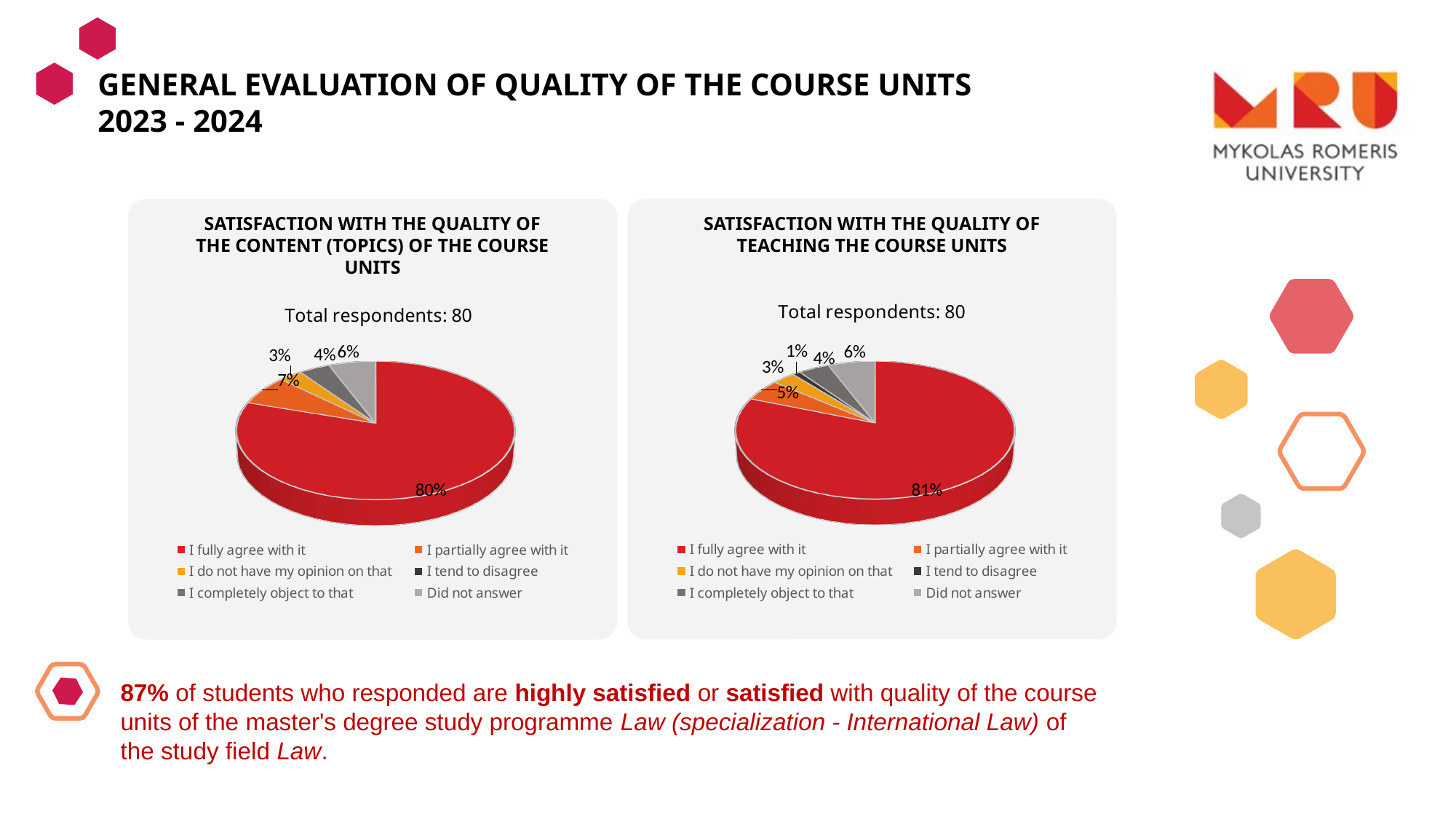
In the 'Satisfaction with the quality of teaching the course units' chart, what share of respondents 'Did not answer'? 6% In the 'Satisfaction with the quality of teaching the course units' chart, what share of respondents chose 'I partially agree with it'? 5% In the 'Satisfaction with the quality of the content (topics) of the course units' chart, what is the difference between the 'I fully agree with it' and 'I partially agree with it' shares? 73% Which response category is the largest slice in the 'Satisfaction with the quality of teaching the course units' chart? I fully agree with it In the 'Satisfaction with the quality of the content (topics) of the course units' chart, what share of respondents chose 'I partially agree with it'? 7% How many response categories does the legend of the 'Satisfaction with the quality of teaching the course units' chart list? 6 In the 'Satisfaction with the quality of teaching the course units' chart, what share of respondents chose 'I fully agree with it'? 81% How many total respondents are reported for the 'Satisfaction with the quality of the content (topics) of the course units' chart? 80 What kind of chart is used in the 'Satisfaction with the quality of the content (topics) of the course units' chart? Pie chart Is the 'I fully agree with it' share larger in the content (topics) chart or in the teaching chart? Teaching chart Which response category is the smallest slice in the 'Satisfaction with the quality of teaching the course units' chart? I tend to disagree In the 'Satisfaction with the quality of the content (topics) of the course units' chart, what share of respondents chose 'I fully agree with it'? 80%